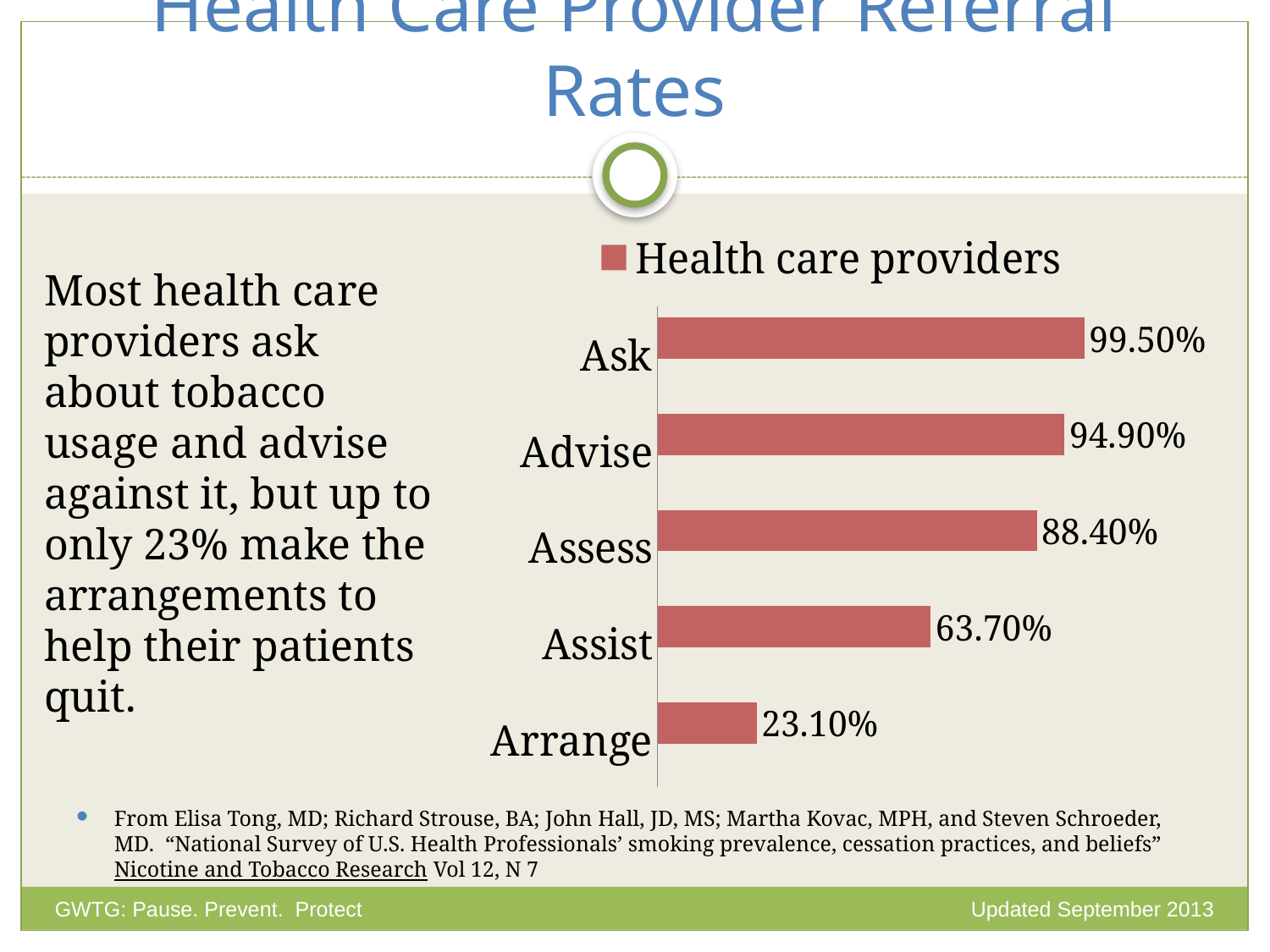
Which is larger, the value for Advise or the value for Assist? Advise What is the value for Assess? 88.40% How many categories are shown in the chart? 5 What is the value for Arrange? 23.10% Which category has the lowest value? Arrange What is the value for Ask? 99.50% What kind of chart is shown on the slide? Bar chart What is the value for Assist? 63.70% What is the value for Advise? 94.90% Which category has the highest value? Ask What is the difference between the values for Ask and Arrange? 76.40% What is the difference between the values for Assess and Assist? 24.70%